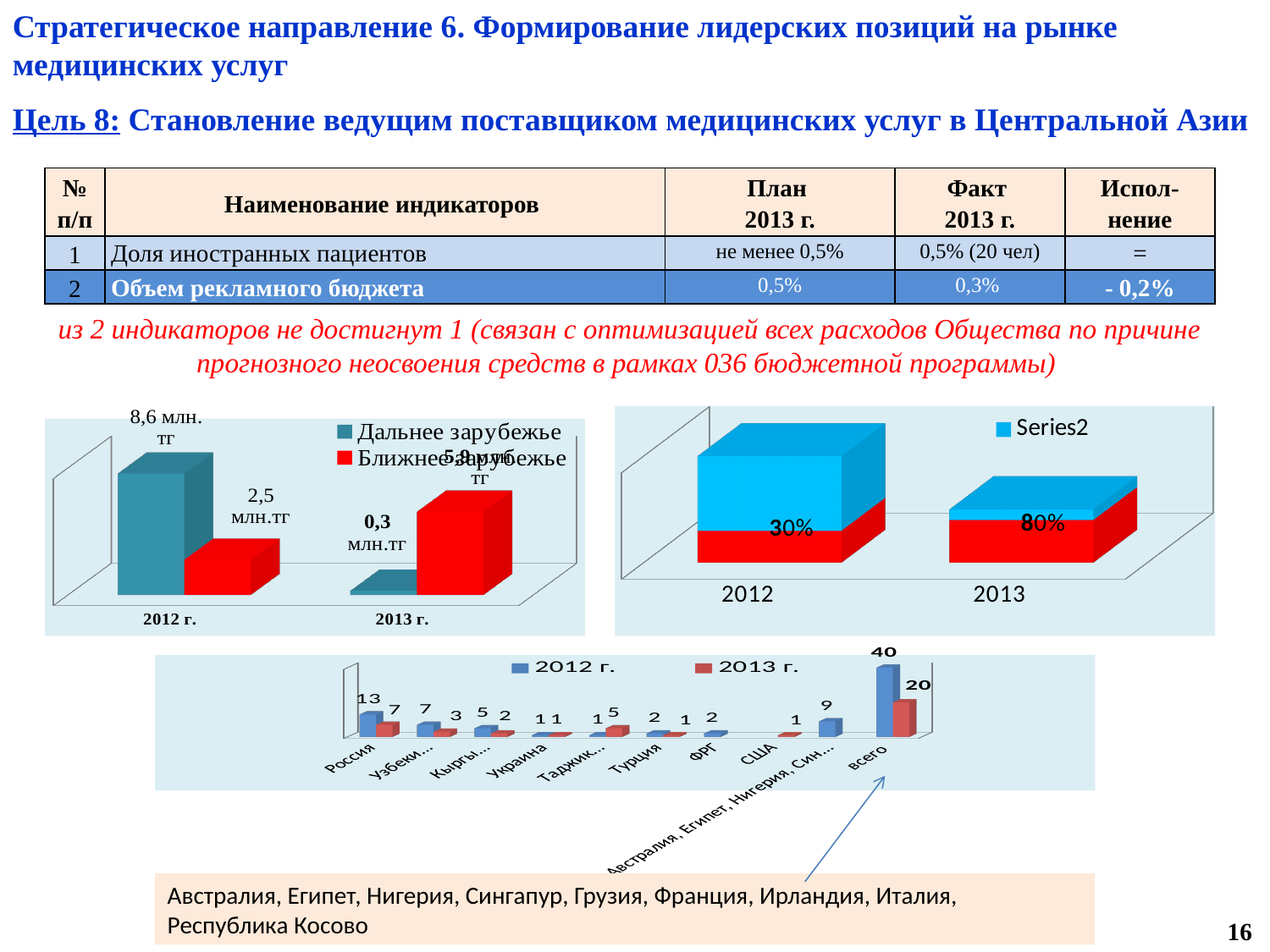
In the right chart, what percentage label is shown for 2013? 80% In the bottom chart, what is the value for всего in the 2013 г. series? 20 In the bottom chart, what is the value for Россия in the 2012 г. series? 13 In the left chart, does the Дальнее зарубежье value rise or fall from 2012 г. to 2013 г.? fall How many series does the legend of the bottom chart list? 2 In the bottom chart, what is the value for Таджик... in the 2013 г. series? 5 In the bottom chart, what is the difference between the 2012 г. and 2013 г. values for Россия? 6 In the bottom chart, which is larger for Таджик...: the 2012 г. value or the 2013 г. value? 2013 г. In the bottom chart, which country category (excluding всего) has the highest 2012 г. value? Россия In the left chart, what is the value for Дальнее зарубежье in 2012 г.? 8,6 млн. тг In the left chart, what is the value for Дальнее зарубежье in 2013 г.? 0,3 млн.тг What kind of chart is the bottom chart? bar chart